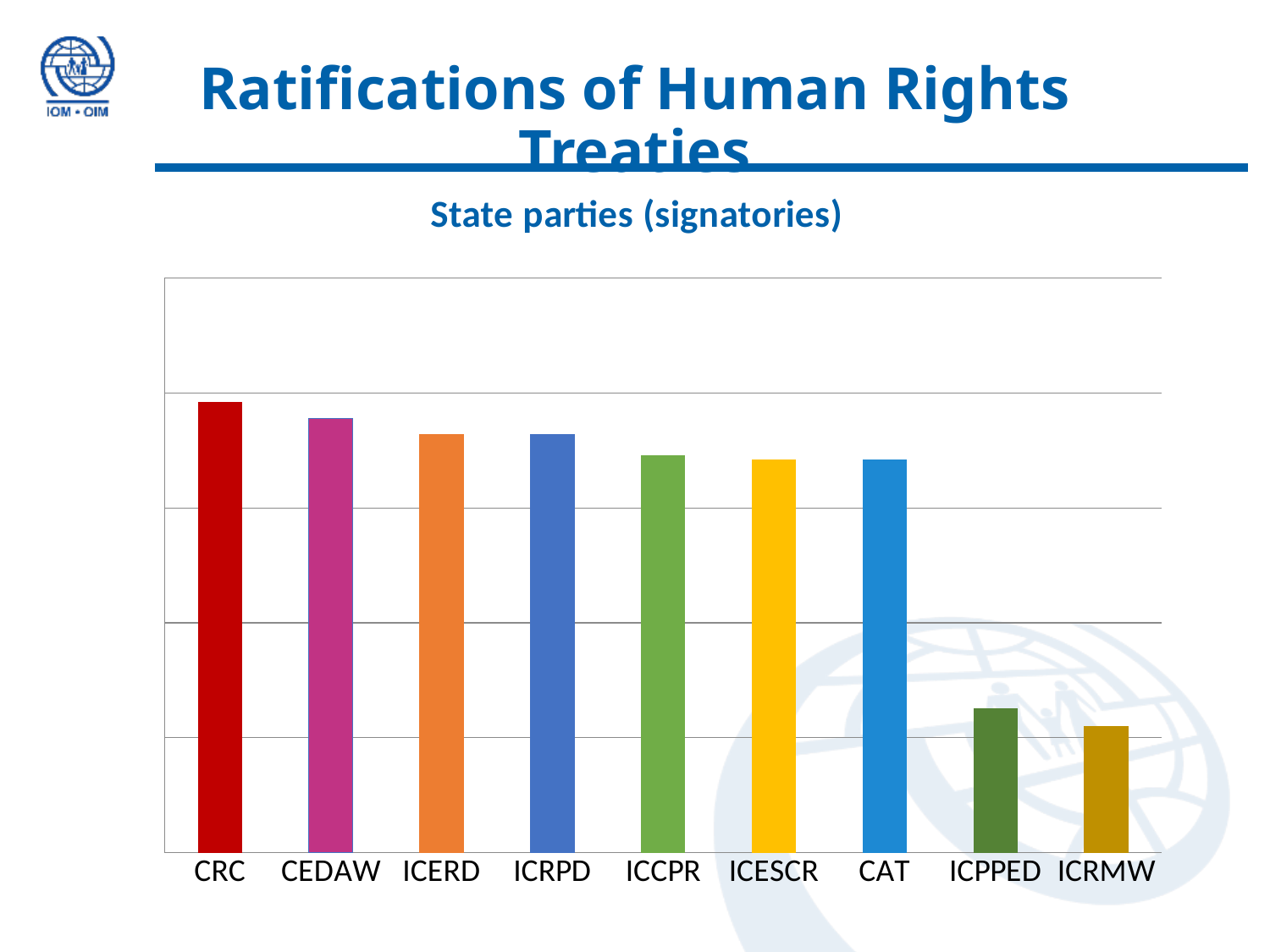
Which treaty has the lowest bar in the chart? ICRMW What is the title of the chart? State parties (signatories) Which has the larger value, CRC or ICPPED? CRC How many treaties are shown on the x axis of the chart? 9 Which has the larger value, CAT or ICRMW? CAT Which treaty has the highest bar in the chart? CRC What kind of chart is shown on the slide? bar chart Which has the larger value, CEDAW or ICPPED? CEDAW Which treaty is listed first on the x axis of the chart? CRC Do the bar values generally rise or fall from left to right along the x axis? fall